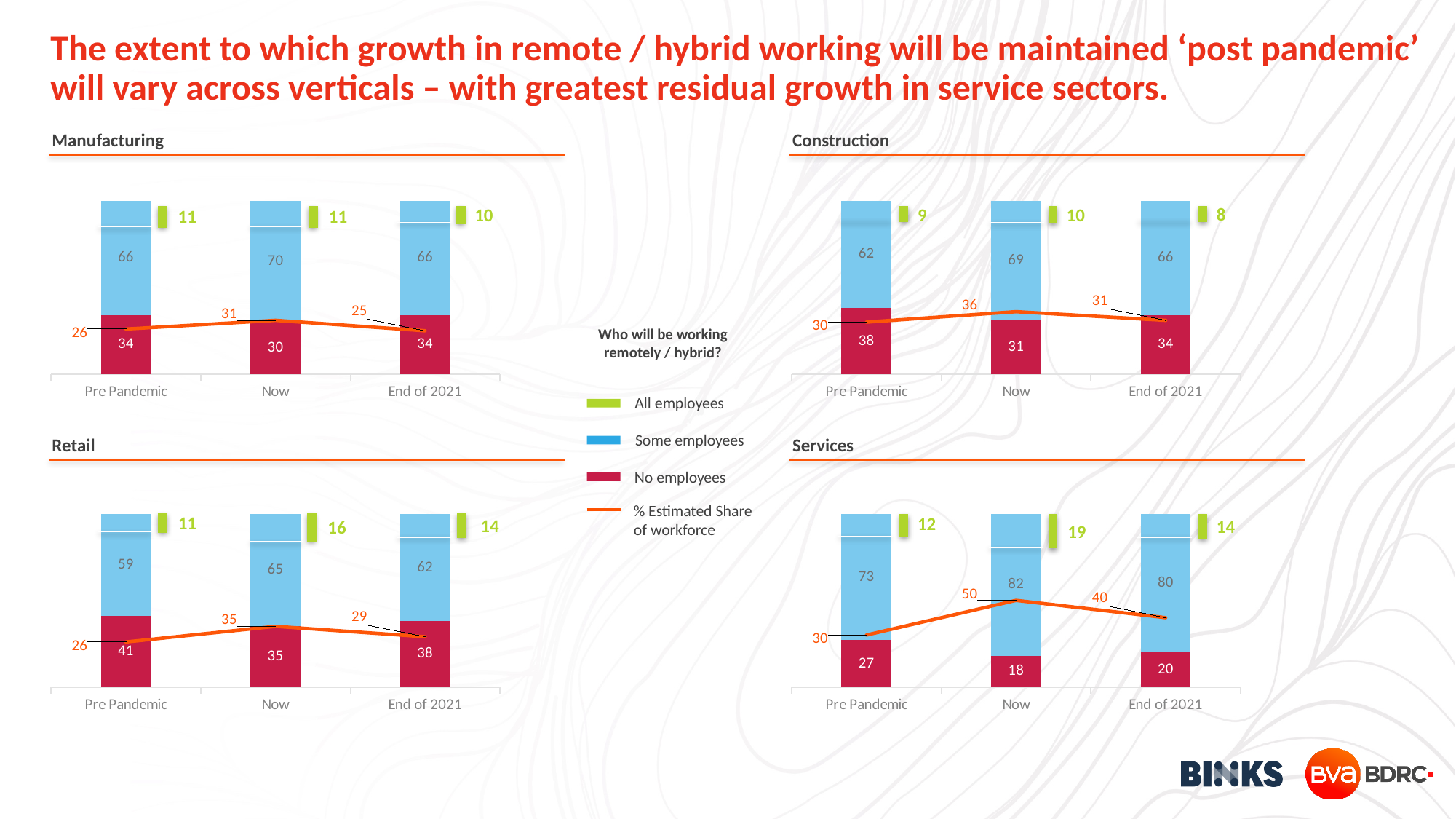
In the Construction chart, what is the All employees value for End of 2021? 8 In the Services chart, which category has the highest % Estimated Share of workforce value? Now In the Retail chart, which category has the lowest All employees value? Pre Pandemic In the Manufacturing chart, what is the Some employees value for Now? 70 Which legend entry is shown in green? All employees In the Services chart, what is the % Estimated Share of workforce value for Now? 50 How many categories are shown on the x axis of the Manufacturing chart? 3 How many series does the legend list? 4 In the Services chart, does the Some employees value rise or fall from Pre Pandemic to Now? rise In the Retail chart, what is the No employees value for Pre Pandemic? 41 In the Construction chart, which is larger: the No employees value for Pre Pandemic or for Now? Pre Pandemic In the Services chart, what is the difference between the % Estimated Share of workforce values for Now and Pre Pandemic? 20